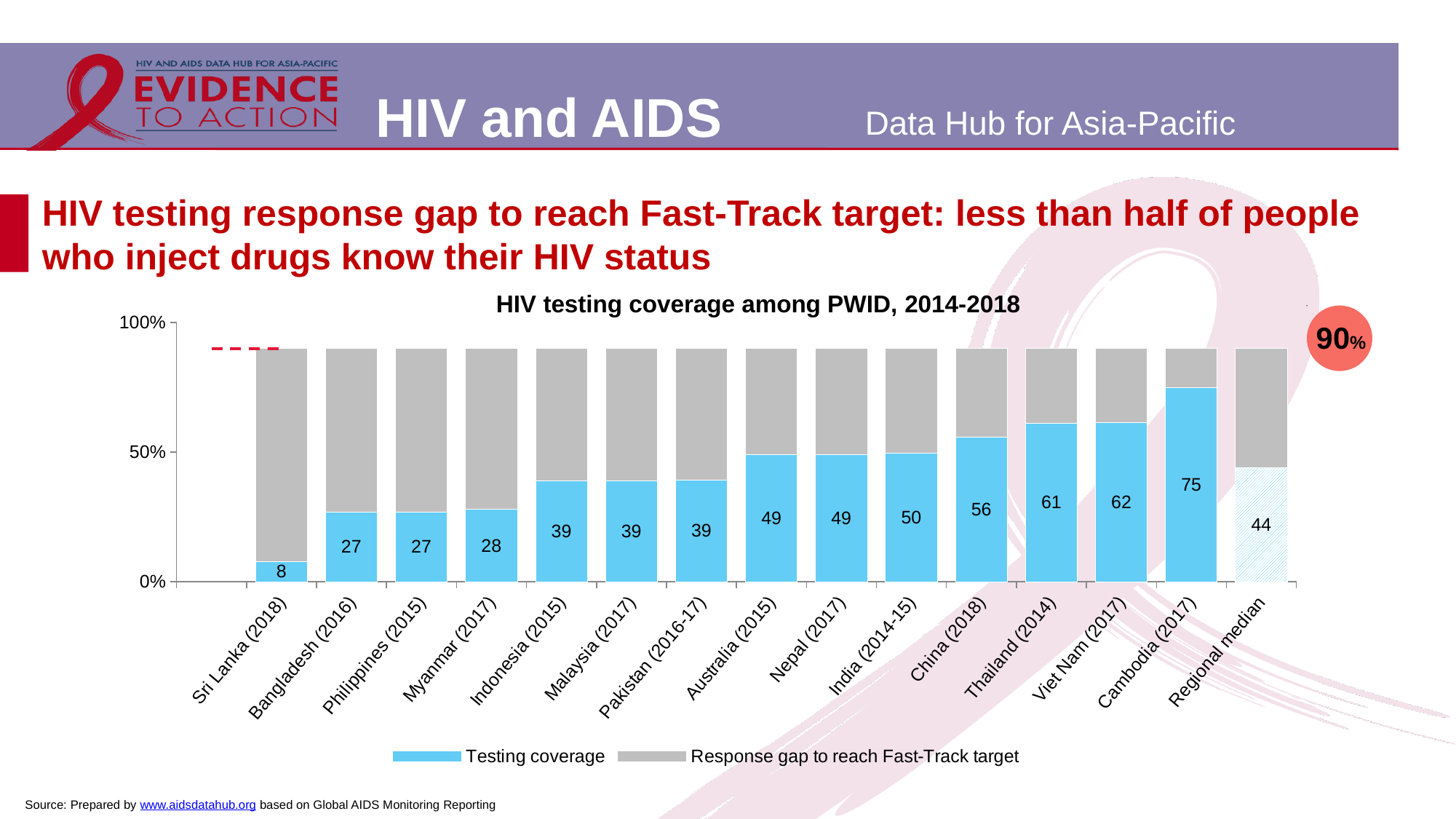
How many series does the legend list? 2 Which country has the lowest testing coverage? Sri Lanka (2018) What is the testing coverage value for Sri Lanka (2018)? 8 What is the difference in testing coverage between Cambodia (2017) and Sri Lanka (2018)? 67 How many bars are shown on the chart, including the Regional median? 15 What is the title of the chart? HIV testing coverage among PWID, 2014-2018 Which has higher testing coverage, Thailand (2014) or China (2018)? Thailand (2014) What kind of chart is shown on the slide? Stacked bar chart Which country has the highest testing coverage? Cambodia (2017) What is the testing coverage value for Cambodia (2017)? 75 Is the testing coverage for Myanmar (2017) greater or less than 50%? less What is the value shown for the Regional median bar? 44